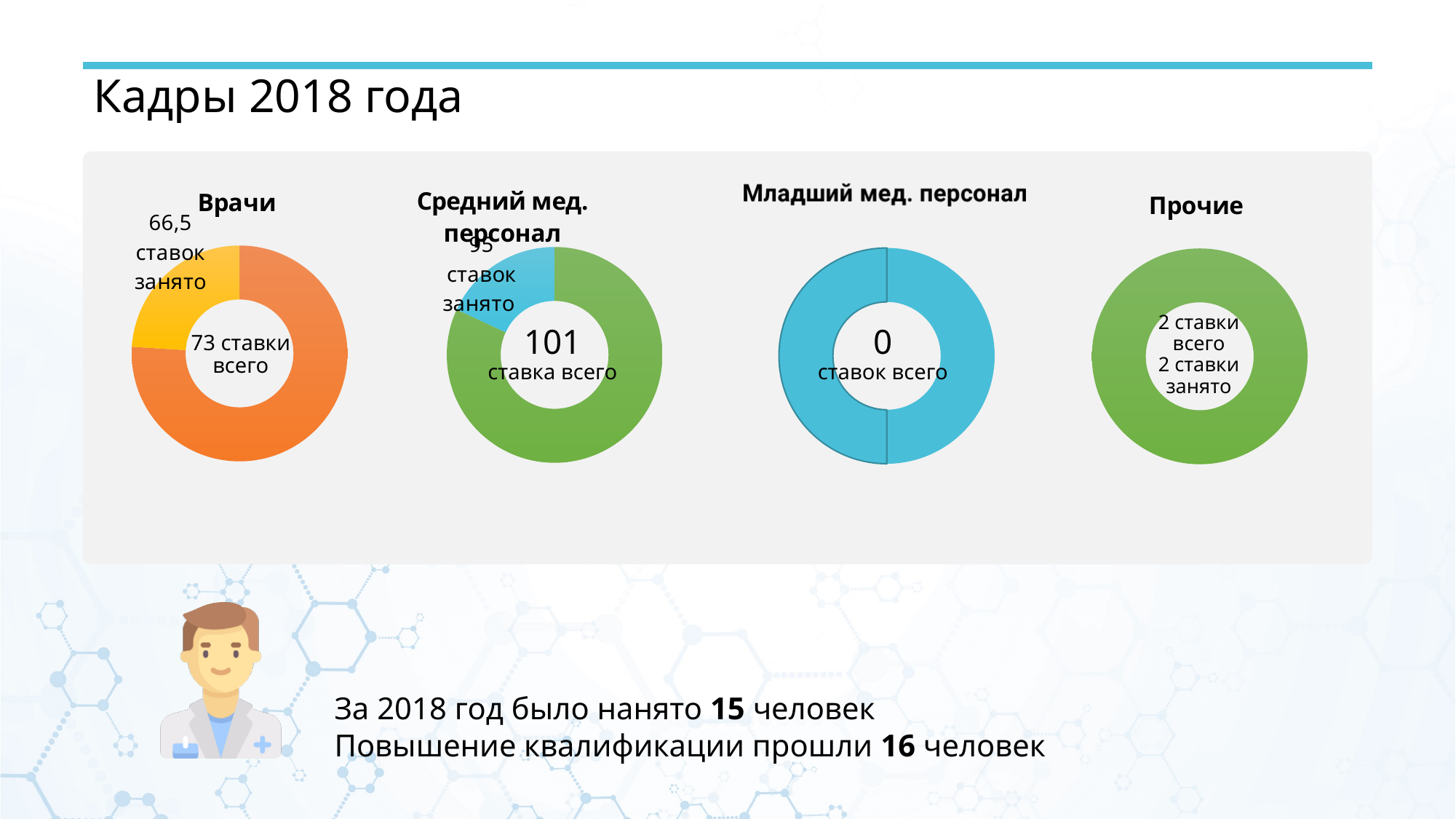
On the 'Средний мед. персонал' chart, what is the total number of positions shown in the centre? 101 Which of the four charts shows the lowest total number of positions? Младший мед. персонал On the 'Врачи' chart, how many positions are occupied (ставок занято)? 66,5 Which chart shows a larger total number of positions: 'Врачи' or 'Средний мед. персонал'? Средний мед. персонал On the 'Врачи' chart, what is the difference between total positions (73) and occupied positions (66,5)? 6,5 On the 'Младший мед. персонал' chart, what total number of positions is shown in the centre? 0 On the 'Прочие' chart, how many positions are occupied (ставки занято)? 2 On the 'Средний мед. персонал' chart, what is the difference between total positions (101) and occupied positions (95)? 6 What kind of chart is used for 'Врачи'? Donut (pie) chart On the 'Врачи' chart, how many total positions (ставки всего) are shown in the centre? 73 ставки всего How many donut charts are shown on the slide? 4 On the 'Средний мед. персонал' chart, how many positions are occupied (ставок занято)? 95